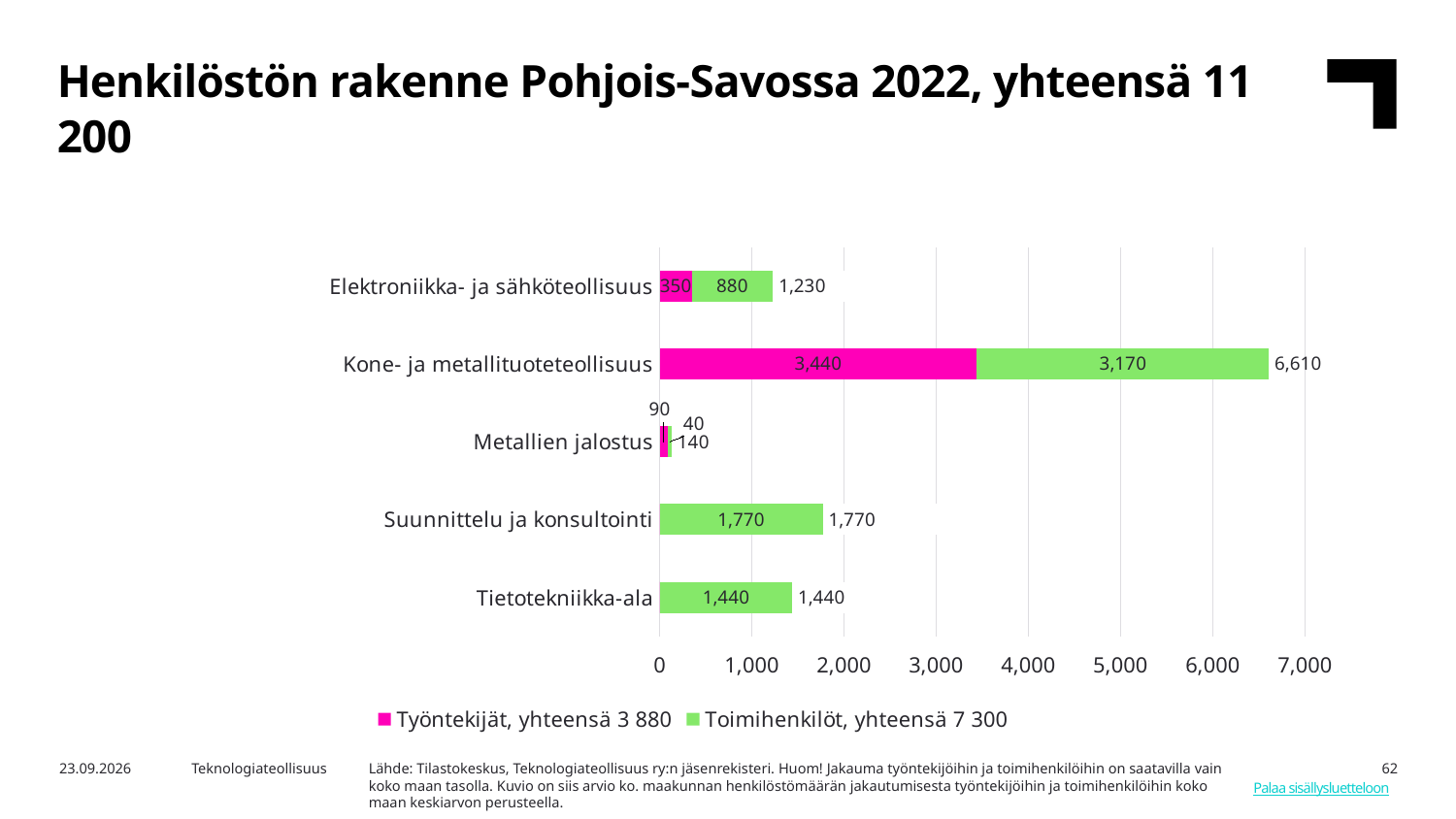
What is the value for Toimihenkilöt in Elektroniikka- ja sähköteollisuus? 880 How many categories are shown on the chart? 5 Which category has the highest total? Kone- ja metallituoteteollisuus What is the total of the stacked bar for Metallien jalostus? 140 What kind of chart is shown on the slide? Bar chart What is the value for Työntekijät in Kone- ja metallituoteteollisuus? 3,440 Which category has the lowest total? Metallien jalostus What is the difference between the Työntekijät and Toimihenkilöt values in Kone- ja metallituoteteollisuus? 270 What is the total of the stacked bar for Kone- ja metallituoteteollisuus? 6,610 Which is larger, the total for Suunnittelu ja konsultointi or the total for Tietotekniikka-ala? Suunnittelu ja konsultointi How many series does the legend list? 2 What is the title of the chart on the slide? Henkilöstön rakenne Pohjois-Savossa 2022, yhteensä 11 200